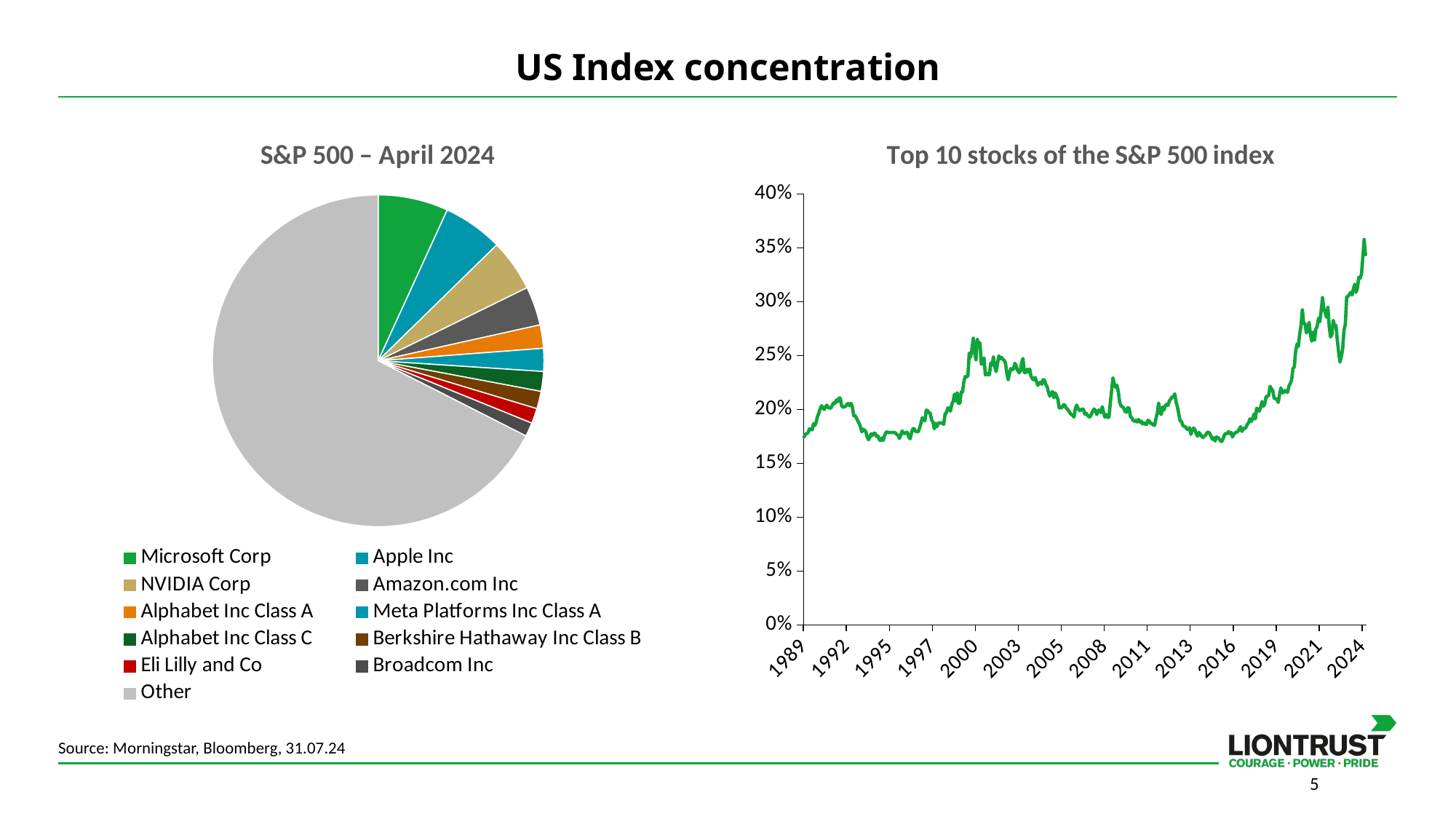
In the 'Top 10 stocks of the S&P 500 index' chart, is the value at the end of the line in 2024 greater or less than 30%? greater In the 'S&P 500 – April 2024' pie chart, which slice is larger, Other or Apple Inc? Other In the 'S&P 500 – April 2024' pie chart, how many categories does the legend list? 11 In the 'Top 10 stocks of the S&P 500 index' chart, does the line overall rise or fall from 1989 to 2024? rise In the 'Top 10 stocks of the S&P 500 index' chart, is the value at the start of the line in 1989 greater or less than 20%? less In the 'Top 10 stocks of the S&P 500 index' chart, what is the highest value shown on the y axis? 40% In the 'S&P 500 – April 2024' pie chart, what colour is the 'Other' slice? grey In the 'S&P 500 – April 2024' pie chart, which slice is larger, Microsoft Corp or Broadcom Inc? Microsoft Corp What kind of chart is the 'S&P 500 – April 2024' chart on the left? pie chart In the 'Top 10 stocks of the S&P 500 index' chart, is the value around 2016 greater or less than 20%? less What kind of chart is the 'Top 10 stocks of the S&P 500 index' chart on the right? line chart In the 'S&P 500 – April 2024' pie chart, which category has the largest slice? Other